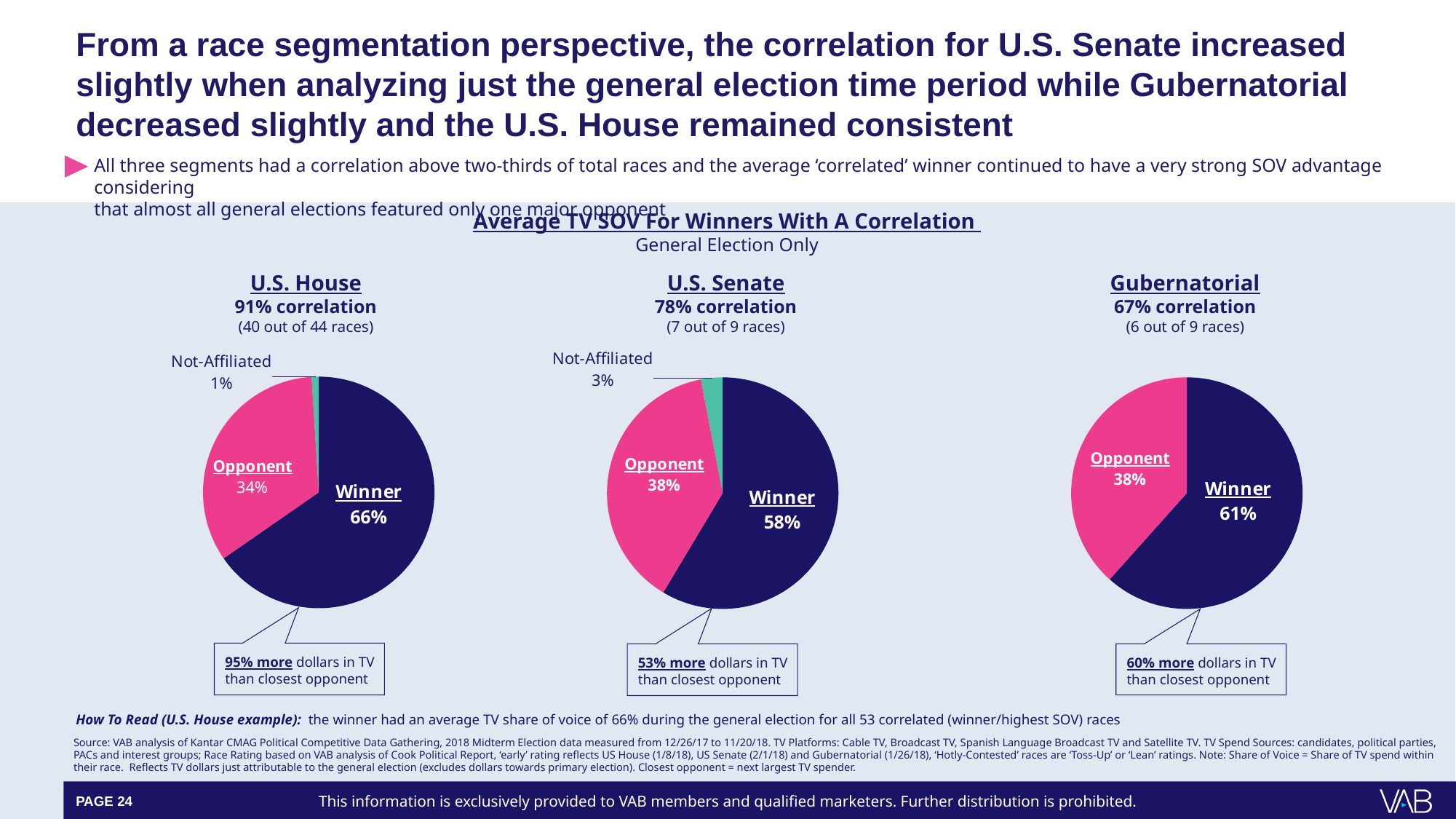
How many pie charts are shown on the slide? 3 In the U.S. House pie chart, what is the value for Winner? 66% In the U.S. House pie chart, which slice is the smallest? Not-Affiliated In the U.S. House pie chart, what is the difference between the Winner and Opponent values? 32% In the U.S. Senate pie chart, what is the value for Not-Affiliated? 3% In the U.S. Senate pie chart, what is the difference between the Winner and Opponent values? 20% How many slices does the U.S. Senate pie chart have? 3 Is the Winner value larger in the U.S. House pie chart or the U.S. Senate pie chart? U.S. House In the Gubernatorial pie chart, what is the value for Winner? 61% In the Gubernatorial pie chart, which slice is the largest? Winner In the U.S. Senate pie chart, what is the value for Opponent? 38% What kind of chart is used for the U.S. House data? Pie chart